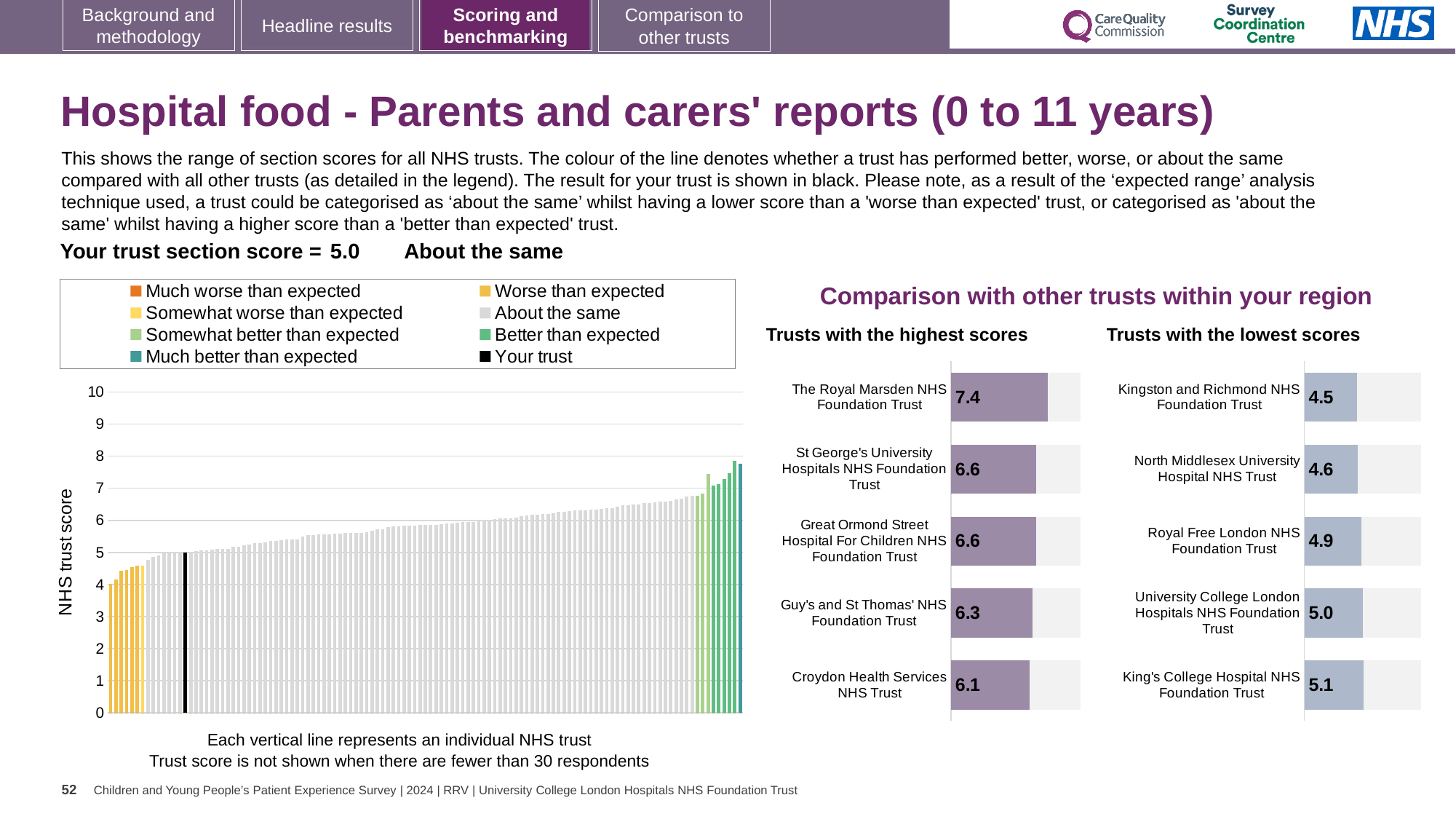
In the 'Trusts with the highest scores' chart, what is the score for Croydon Health Services NHS Trust? 6.1 In the 'Trusts with the highest scores' chart, which trust has the highest score? The Royal Marsden NHS Foundation Trust In the main 'NHS trust score' chart on the left, do the bar values rise or fall from left to right? rise In the 'Trusts with the lowest scores' chart, which has the larger score: North Middlesex University Hospital NHS Trust or King's College Hospital NHS Foundation Trust? King's College Hospital NHS Foundation Trust In the 'Trusts with the highest scores' chart, what is the score for The Royal Marsden NHS Foundation Trust? 7.4 In the 'Trusts with the highest scores' chart, what is the difference between the scores of The Royal Marsden NHS Foundation Trust and Croydon Health Services NHS Trust? 1.3 In the 'Trusts with the lowest scores' chart, which trust has the lowest score? Kingston and Richmond NHS Foundation Trust How many trusts are shown in the 'Trusts with the lowest scores' chart? 5 In the main 'NHS trust score' chart on the left, is the value of the tallest bar greater or less than 7? greater How many entries does the legend of the main 'NHS trust score' chart on the left list? 8 In the 'Trusts with the lowest scores' chart, what is the score for Royal Free London NHS Foundation Trust? 4.9 In the 'Trusts with the lowest scores' chart, what is the difference between the scores of King's College Hospital NHS Foundation Trust and Kingston and Richmond NHS Foundation Trust? 0.6